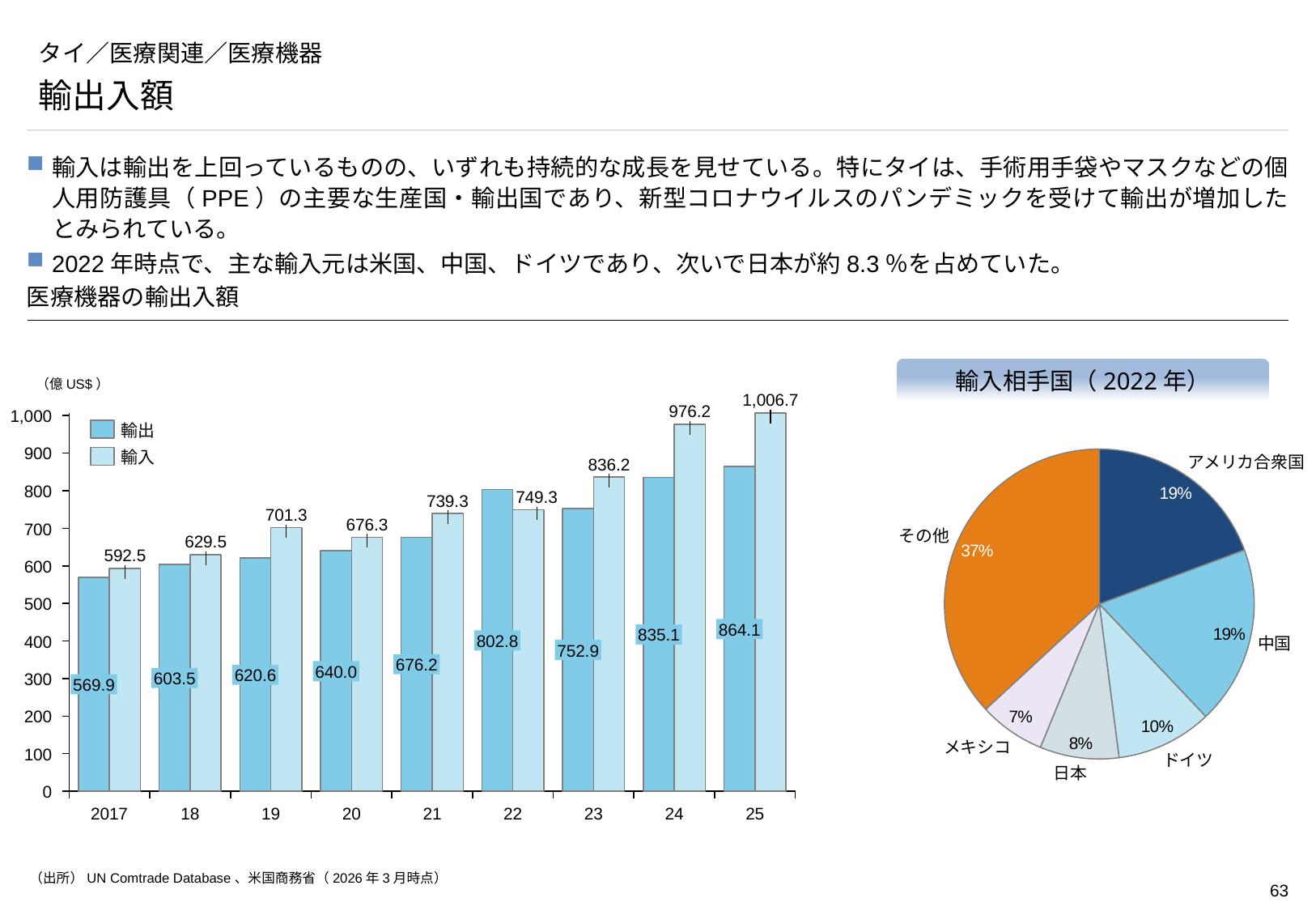
In the bar chart 医療機器の輸出入額, which year has the lowest 輸入 value? 2017 What kind of chart is 輸入相手国（2022年）? pie chart In the pie chart 輸入相手国（2022年）, what share does 日本 hold? 8% In the bar chart 医療機器の輸出入額, what is the 輸入 value for 19? 701.3 In the bar chart 医療機器の輸出入額, which year has the highest 輸出 value? 25 In the bar chart 医療機器の輸出入額, what is the 輸出 value for 2017? 569.9 In the bar chart 医療機器の輸出入額, how many years are shown on the x axis? 9 In the pie chart 輸入相手国（2022年）, which slice is the largest? その他 In the bar chart 医療機器の輸出入額, what is the 輸入 value for 25? 1,006.7 In the bar chart 医療機器の輸出入額, which is larger for 22, 輸出 or 輸入? 輸出 In the bar chart 医療機器の輸出入額, what is the difference between the 輸入 and 輸出 values for 24? 141.1 In the bar chart 医療機器の輸出入額, how many series does the legend list? 2